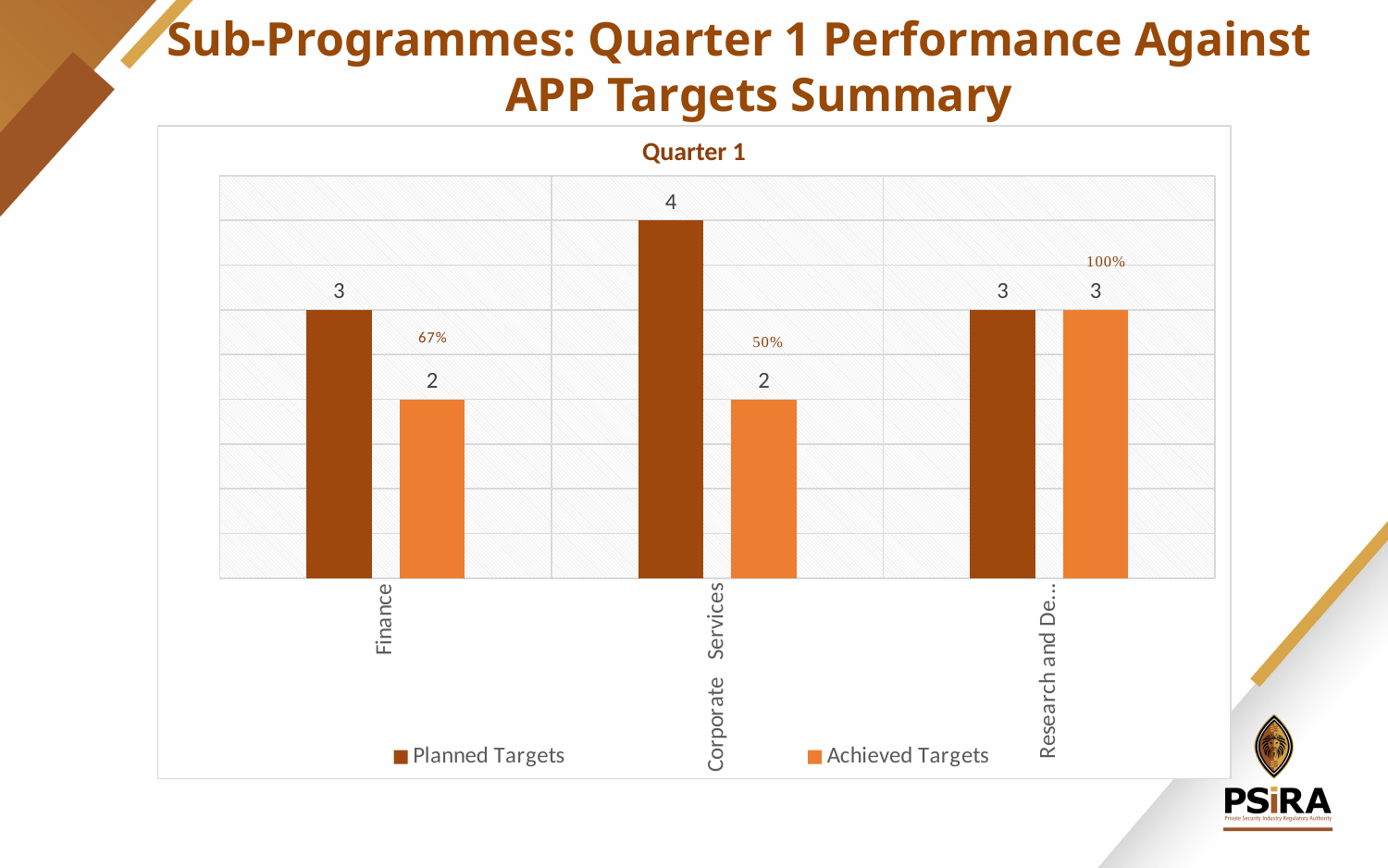
What is the Planned Targets value for Finance? 3 How many series does the legend list? 2 How many categories are shown on the x axis of the chart? 3 What is the difference between Planned Targets and Achieved Targets for Finance? 1 What is the difference between Planned Targets and Achieved Targets for Corporate Services? 2 What percentage label is shown above the Achieved Targets bar for Finance? 67% What is the Achieved Targets value for Corporate Services? 2 What is the Planned Targets value for Corporate Services? 4 Which category has the highest Planned Targets value? Corporate Services Which is larger for Finance: Planned Targets or Achieved Targets? Planned Targets What percentage label is shown above the Achieved Targets bar for Corporate Services? 50% What type of chart is shown on the slide? Bar chart